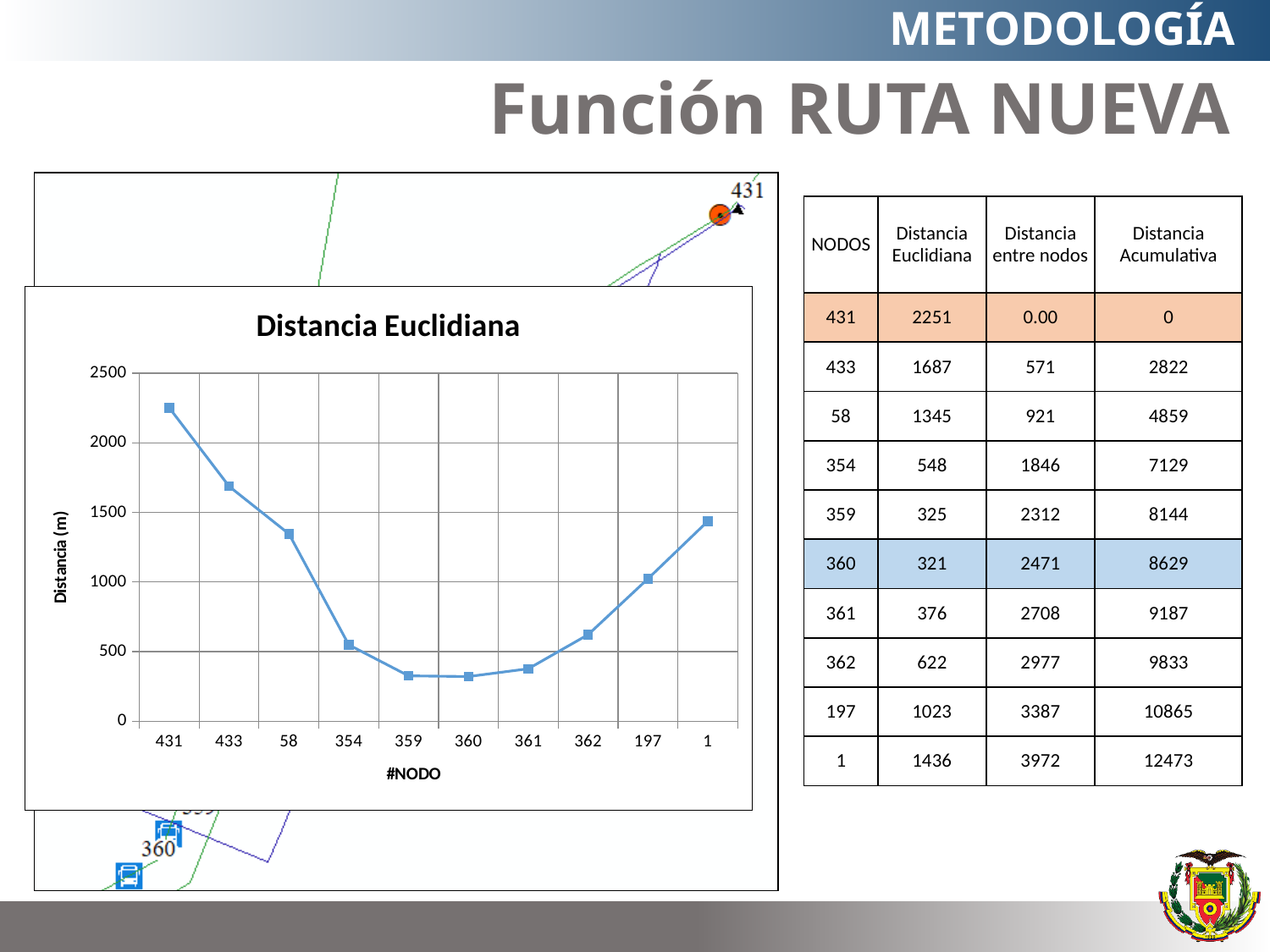
What is the label of the y axis in the 'Distancia Euclidiana' chart? Distancia (m) In the 'Distancia Euclidiana' chart, which has the larger value, node 433 or node 197? 433 In the 'Distancia Euclidiana' chart, which has the larger value, node 431 or node 1? 431 What kind of chart is the 'Distancia Euclidiana' chart? line chart In the 'Distancia Euclidiana' chart, do the values rise or fall from node 431 to node 360? fall Which node has the highest value in the 'Distancia Euclidiana' chart? 431 In the 'Distancia Euclidiana' chart, is the value for node 359 greater or less than 500? less In the 'Distancia Euclidiana' chart, is the value for node 58 greater or less than 1500? less In the 'Distancia Euclidiana' chart, is the value for node 433 greater or less than 1500? greater How many nodes are plotted along the x axis of the 'Distancia Euclidiana' chart? 10